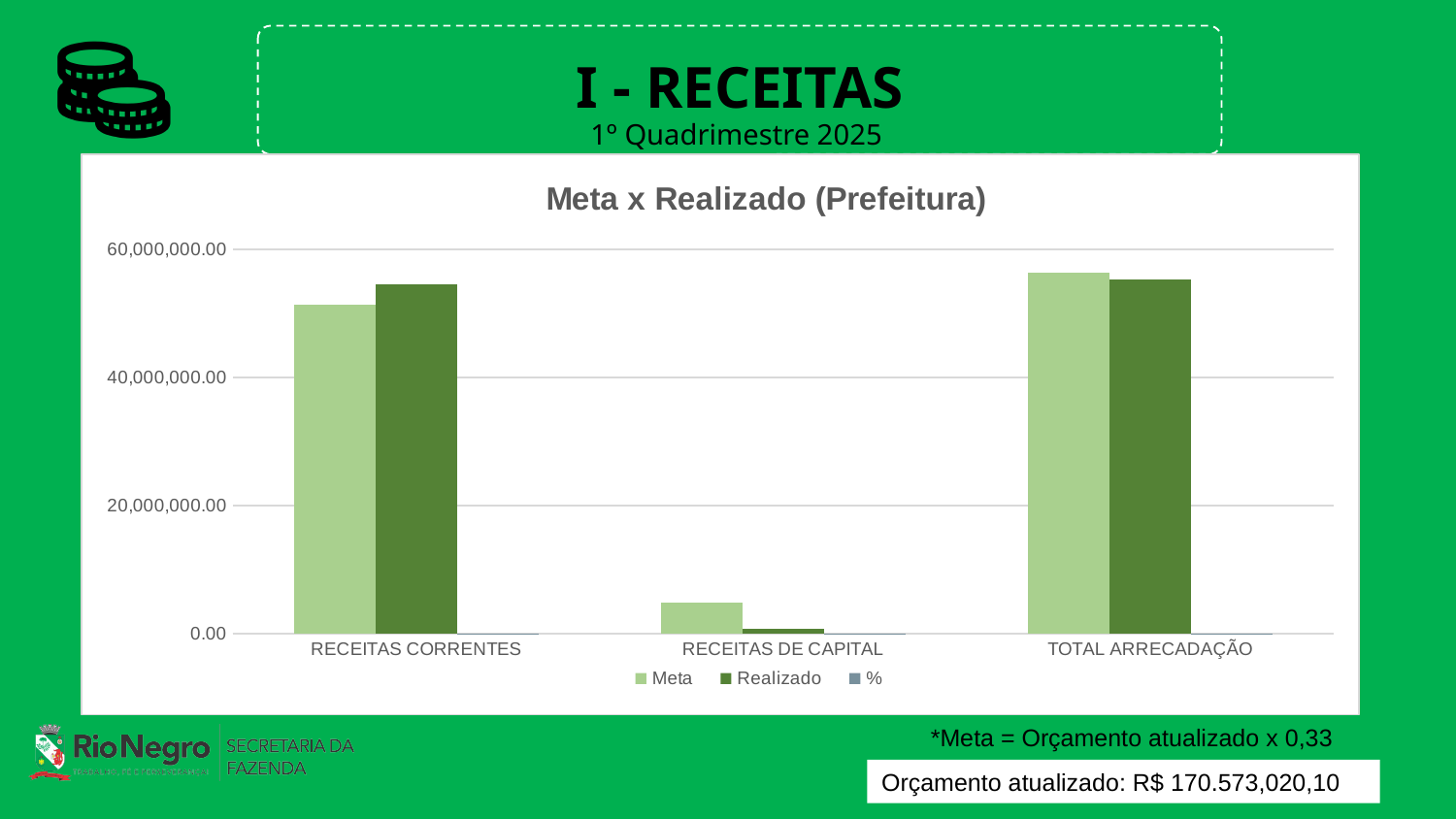
Is the Meta value for RECEITAS CORRENTES greater or less than 40,000,000.00? greater Which series are listed in the chart legend? Meta, Realizado, % Which category has the lowest Meta value? RECEITAS DE CAPITAL What kind of chart is shown on the slide? bar chart How many series does the chart legend list? 3 How many categories are shown on the x axis of the chart? 3 Is the Realizado value for TOTAL ARRECADAÇÃO greater or less than 60,000,000.00? less For RECEITAS DE CAPITAL, which is larger: Meta or Realizado? Meta Is the Realizado value for RECEITAS DE CAPITAL greater or less than 20,000,000.00? less Which category has the highest Meta value? TOTAL ARRECADAÇÃO What is the title of the chart? Meta x Realizado (Prefeitura) For RECEITAS CORRENTES, which is larger: Meta or Realizado? Realizado